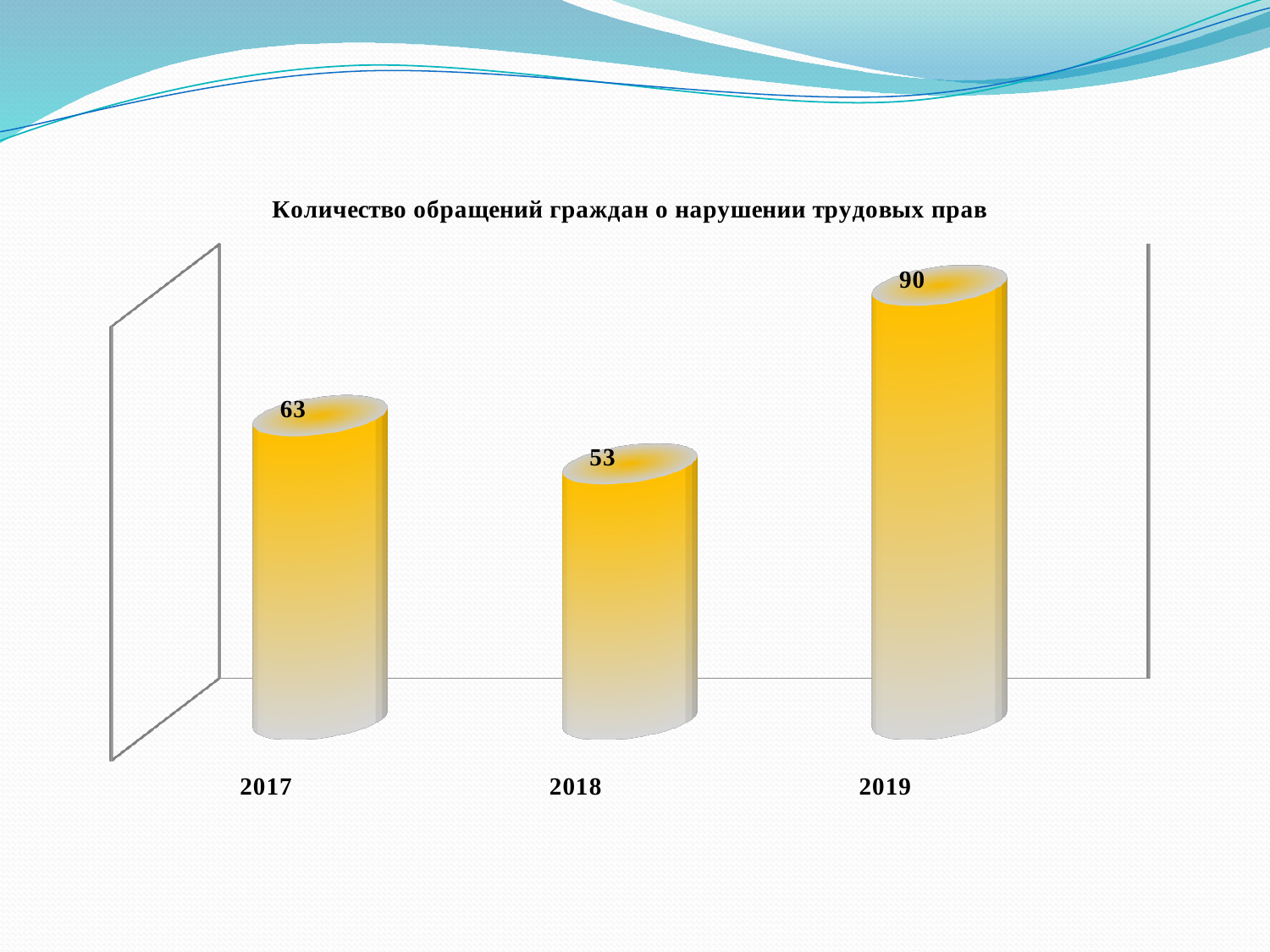
Does the value rise or fall from 2018 to 2019? rise Which year has the lowest value? 2018 What is the difference between the values for 2019 and 2018? 37 What is the value for 2017? 63 What is the value for 2018? 53 Which is larger, the value for 2017 or the value for 2018? 2017 How many years are shown on the chart? 3 What is the value for 2019? 90 What kind of chart is this? bar chart What is the difference between the values for 2017 and 2018? 10 What is the title of the chart? Количество обращений граждан о нарушении трудовых прав Which year has the highest value? 2019